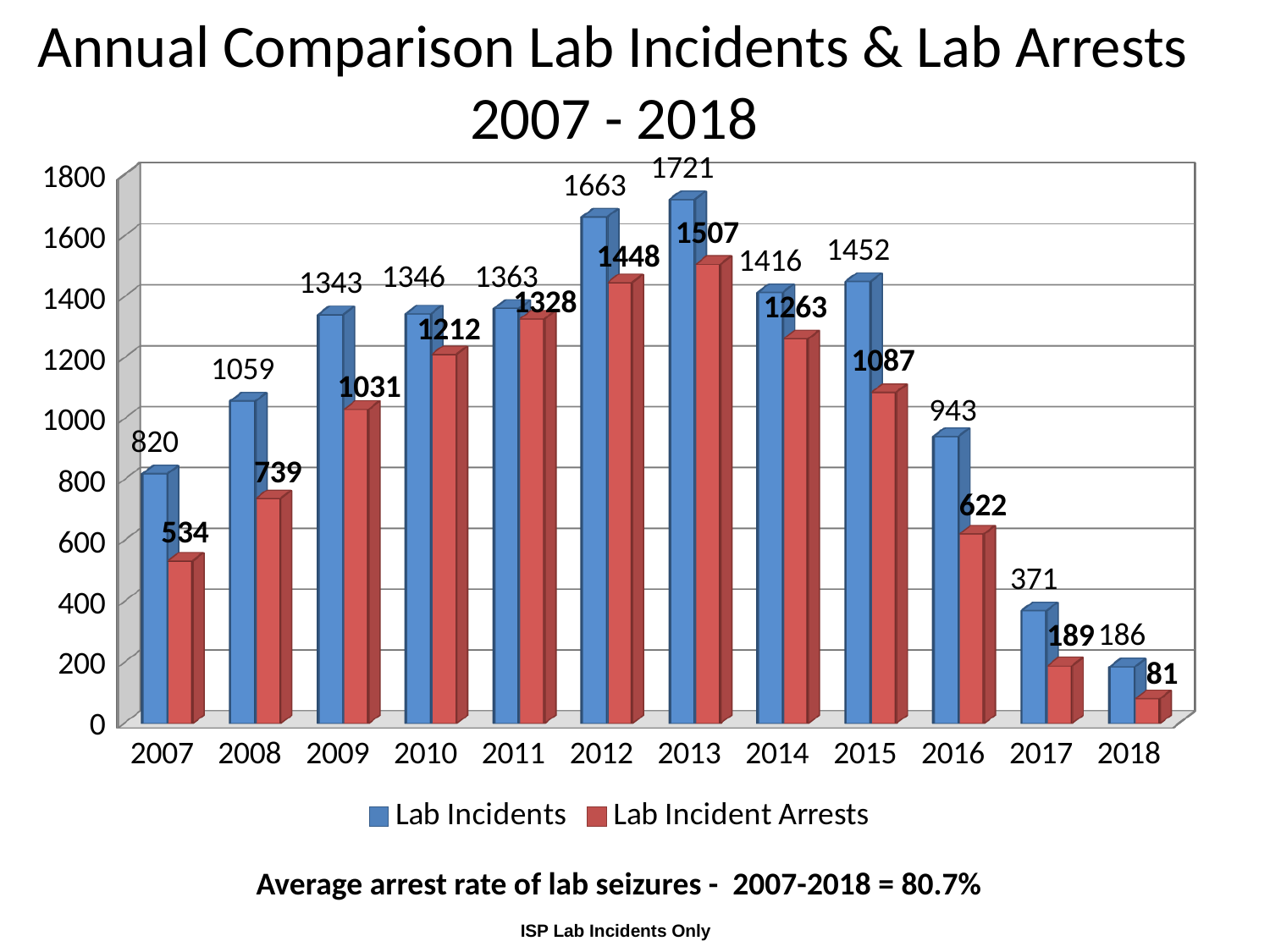
How many series does the legend list? 2 Do the Lab Incidents values rise or fall from 2013 to 2018? Fall Which year has the lowest value for Lab Incident Arrests? 2018 What is the difference between Lab Incidents and Lab Incident Arrests in 2012? 215 What colour are the Lab Incident Arrests bars? Red What is the value of Lab Incident Arrests for 2009? 1031 What is the value of Lab Incidents for 2013? 1721 What kind of chart is shown on the slide? Bar chart What is the value of Lab Incident Arrests for 2018? 81 How many years are shown on the x axis? 12 Which year has the highest value for Lab Incidents? 2013 Which is larger: Lab Incidents in 2008 or Lab Incidents in 2016? Lab Incidents in 2008